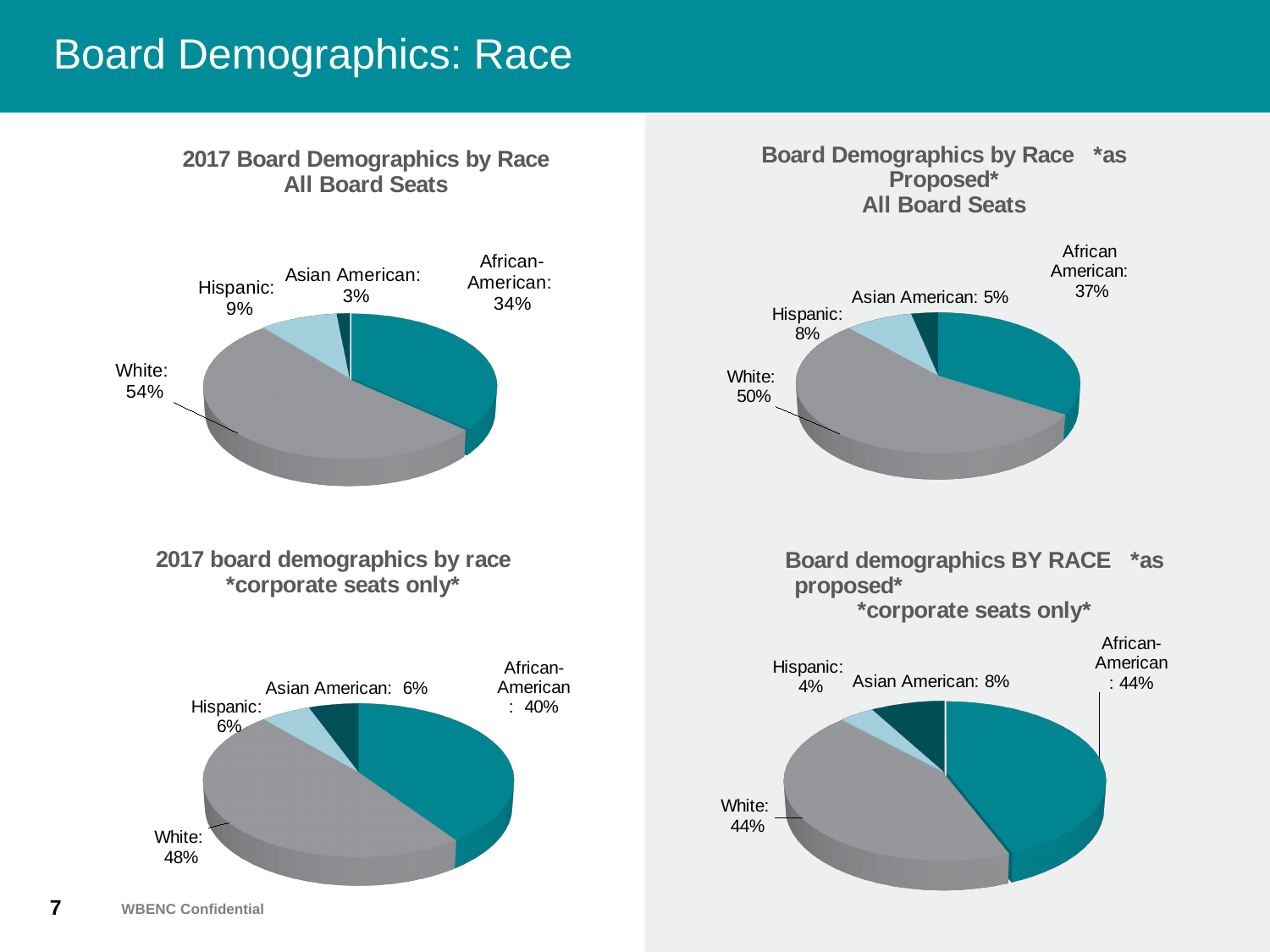
In the 'Board Demographics by Race *as Proposed* All Board Seats' chart, what share is African American? 37% How many categories does the '2017 Board Demographics by Race All Board Seats' chart show? 4 In the 'Board Demographics by Race *as Proposed* All Board Seats' chart, which category has the largest share? White In the 'Board demographics BY RACE *as proposed* *corporate seats only*' chart, which is larger, Asian American or Hispanic? Asian American In the 'Board demographics BY RACE *as proposed* *corporate seats only*' chart, what share is Hispanic? 4% In the '2017 board demographics by race *corporate seats only*' chart, what is the difference between the White and African-American shares? 8% In the 'Board Demographics by Race *as Proposed* All Board Seats' chart, what is the difference between the White and Hispanic shares? 42% In the '2017 Board Demographics by Race All Board Seats' chart, which category has the smallest share? Asian American In the '2017 board demographics by race *corporate seats only*' chart, what share is African-American? 40% What type of chart is used for the 'Board Demographics by Race *as Proposed* All Board Seats' chart? Pie chart In the '2017 Board Demographics by Race All Board Seats' chart, what share is White? 54% How many pie charts are shown on the slide? 4